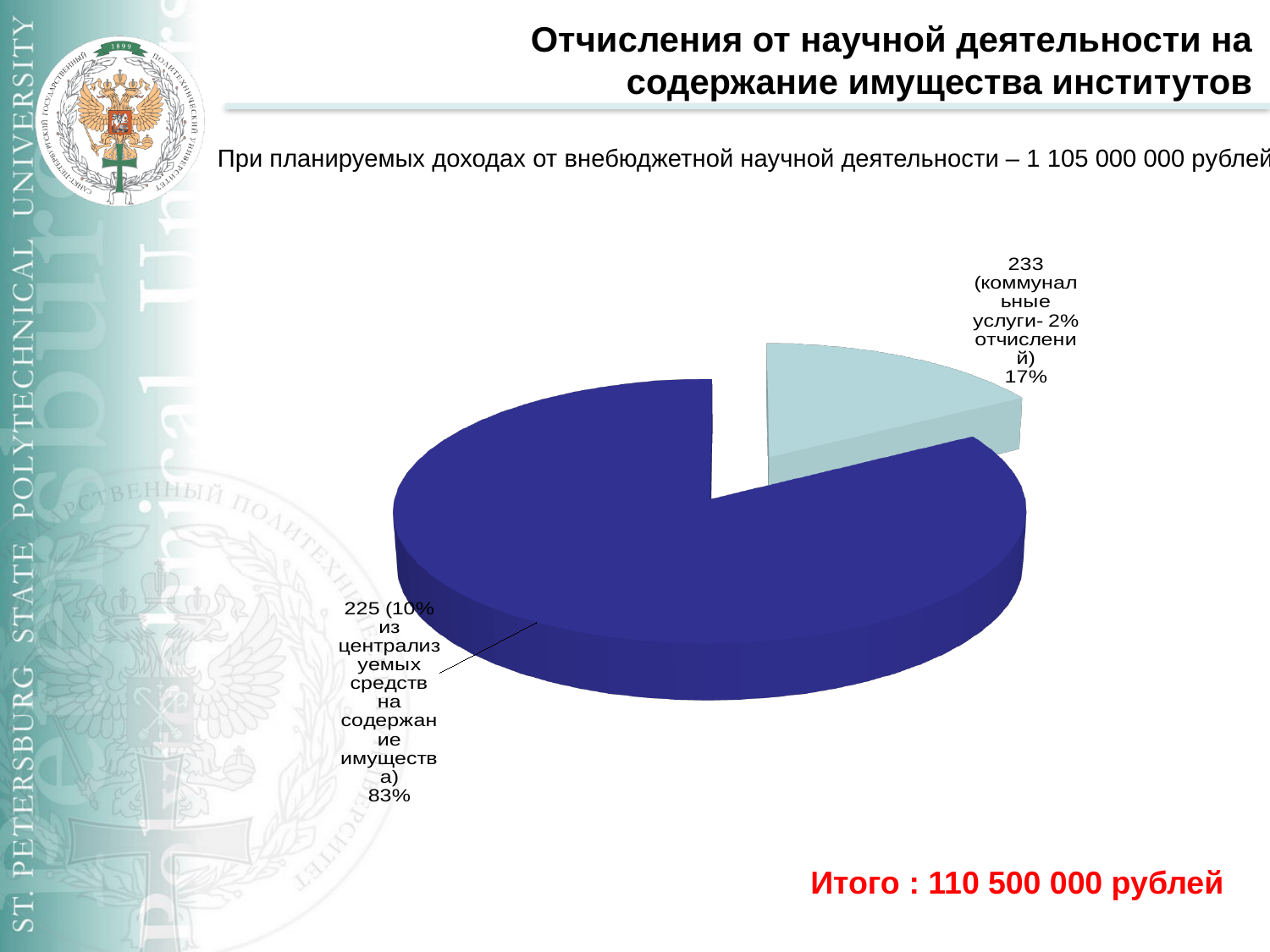
What kind of chart is shown on the slide? pie chart Which slice of the pie chart is the smallest? 233 (коммунальные услуги- 2% отчислений) What share of the pie does the slice labelled "225 (10% из централизуемых средств на содержание имущества)" represent? 83% What is the difference in percentage points between the 83% slice and the 17% slice? 66 Is the share of the slice labelled "233 (коммунальные услуги- 2% отчислений)" greater or less than 50%? less Which slice of the pie chart is the largest? 225 (10% из централизуемых средств на содержание имущества) What colour is the largest slice of the pie chart? dark blue How many slices does the pie chart have? 2 Which slice is larger: the one for "225" or the one for "233"? 225 (10% из централизуемых средств на содержание имущества) What total amount is stated in red below the chart? 110 500 000 рублей What share of the pie does the slice labelled "233 (коммунальные услуги- 2% отчислений)" represent? 17%